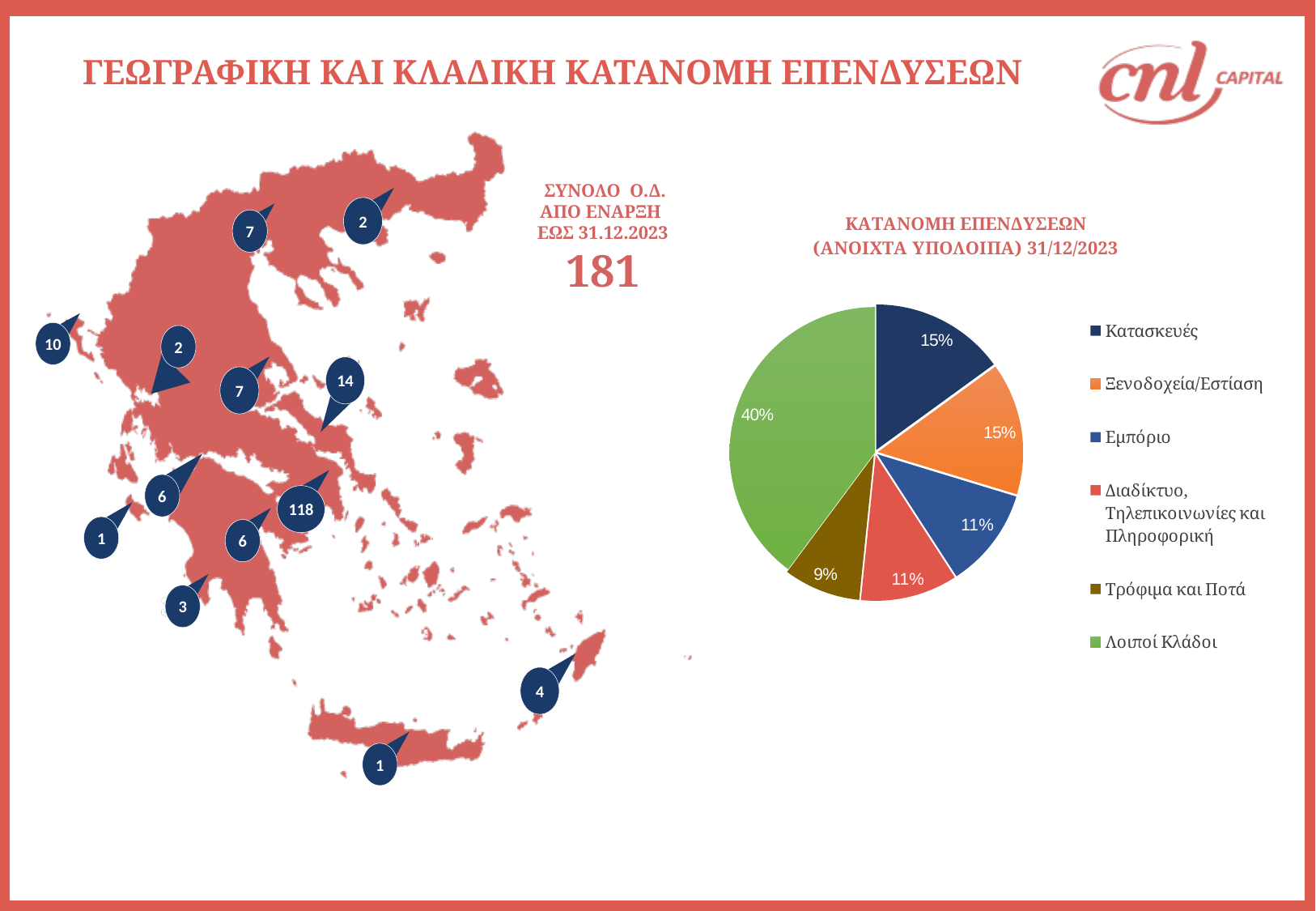
In the pie chart, what share is shown for Κατασκευές? 15% Which category has the smallest slice in the pie chart? Τρόφιμα και Ποτά In the pie chart, which is larger: Εμπόριο or Τρόφιμα και Ποτά? Εμπόριο What colour is the Λοιποί Κλάδοι slice in the pie chart? Green How many categories does the pie chart legend list? 6 In the pie chart, what share is shown for Εμπόριο? 11% In the pie chart, what is the difference in percentage points between Λοιποί Κλάδοι and Κατασκευές? 25 In the pie chart, what share is shown for Ξενοδοχεία/Εστίαση? 15% In the pie chart, what share is shown for Λοιποί Κλάδοι? 40% Which category has the largest slice in the pie chart? Λοιποί Κλάδοι What kind of chart is shown under the title ΚΑΤΑΝΟΜΗ ΕΠΕΝΔΥΣΕΩΝ (ΑΝΟΙΧΤΑ ΥΠΟΛΟΙΠΑ) 31/12/2023? Pie chart In the pie chart, what share is shown for Τρόφιμα και Ποτά? 9%